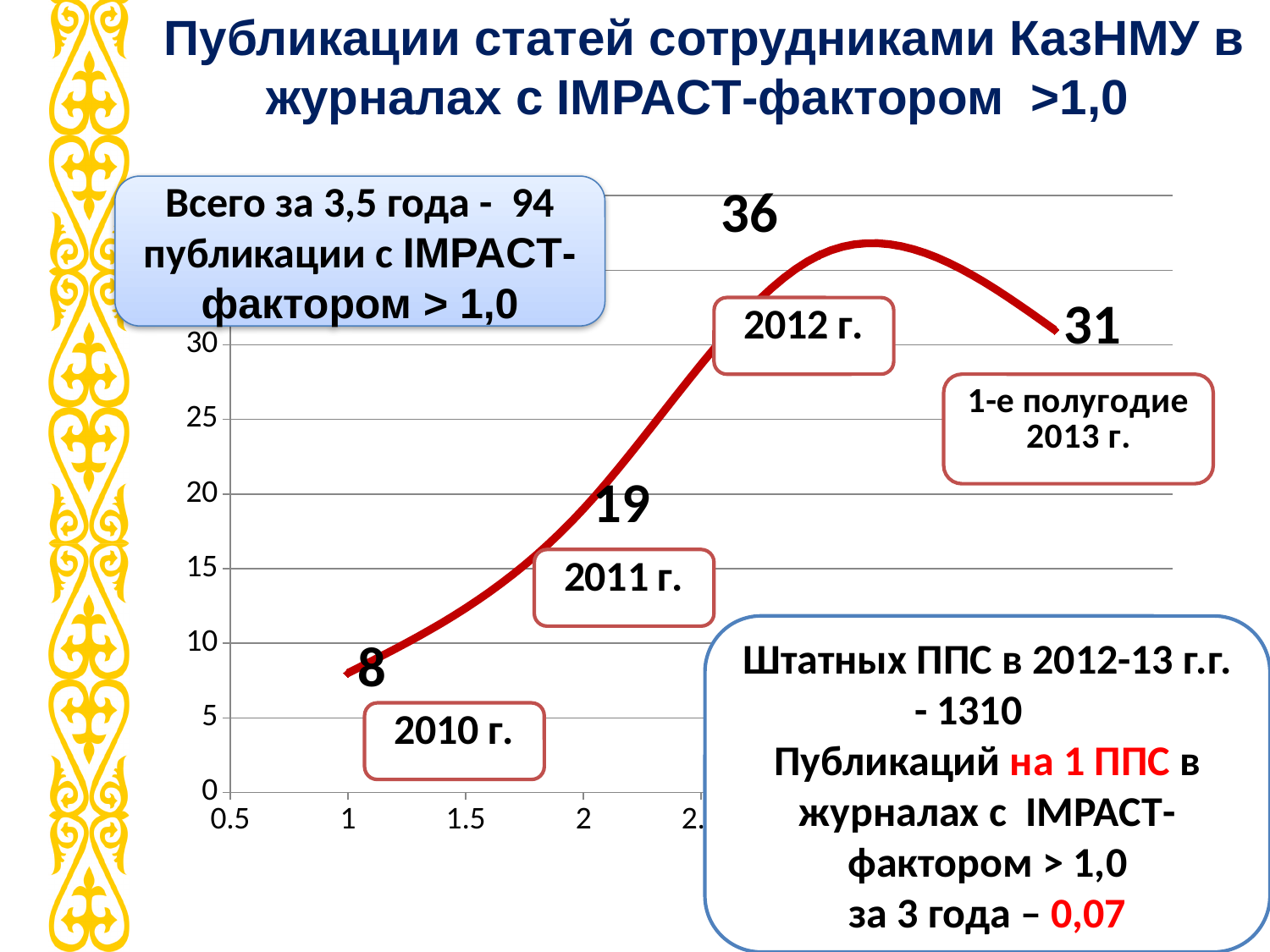
What is the number of publications for 2010 г.? 8 How many data points are plotted on the chart? 4 What is the difference between the values for 2012 г. and 1-е полугодие 2013 г.? 5 What is the number of publications for 2011 г.? 19 Which period has the highest number of publications? 2012 г. What is the difference between the values for 2012 г. and 2011 г.? 17 What is the number of publications for 2012 г.? 36 What is the number of publications for 1-е полугодие 2013 г.? 31 Which period has the lowest number of publications? 2010 г. What type of chart is shown on the slide? line chart According to the text box on the slide, how many publications with IMPACT-factor > 1,0 were there in total over 3,5 years? 94 Which is larger, the value for 2011 г. or the value for 1-е полугодие 2013 г.? 1-е полугодие 2013 г.